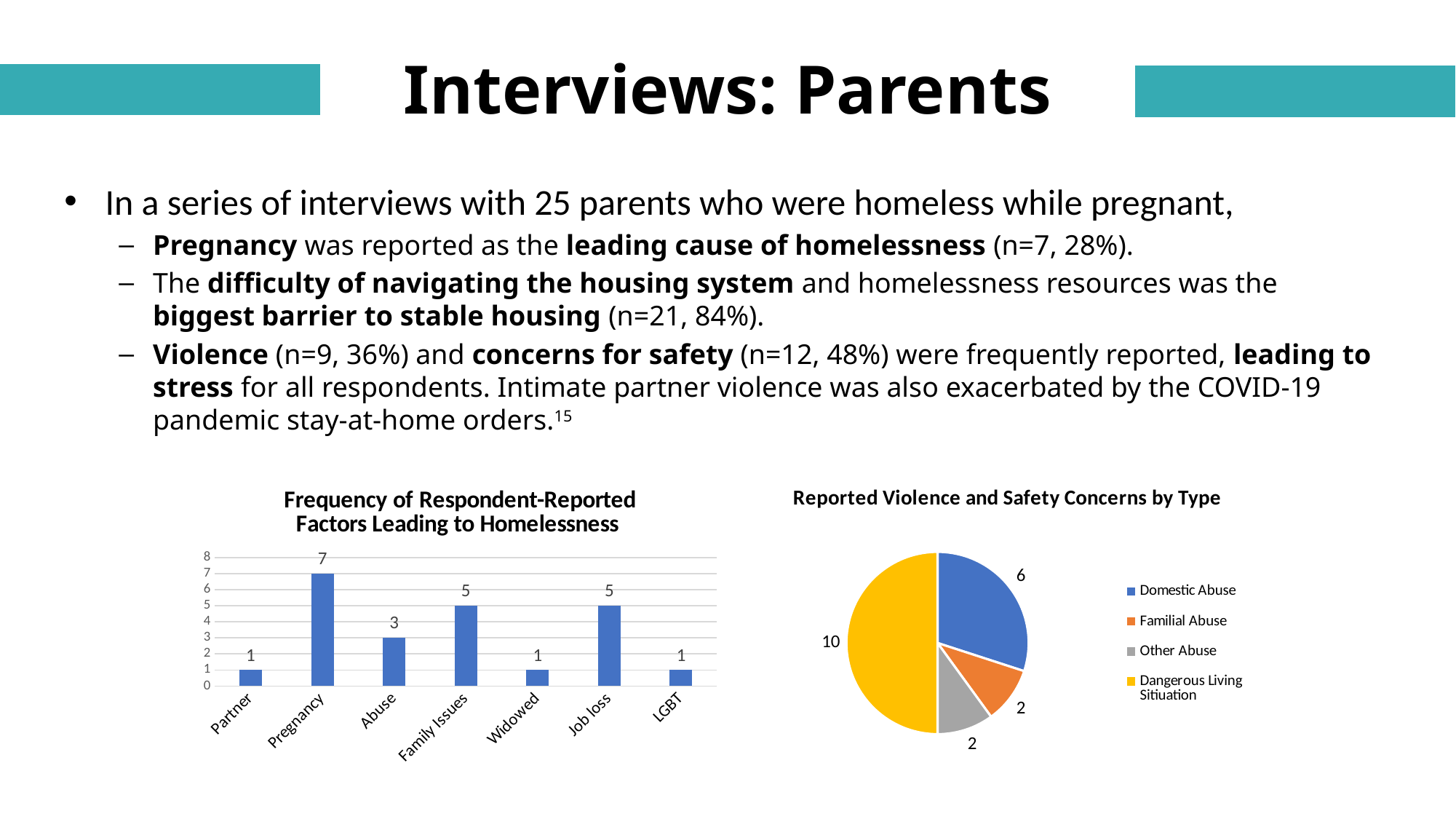
What kind of chart is 'Frequency of Respondent-Reported Factors Leading to Homelessness'? Bar chart In the 'Frequency of Respondent-Reported Factors Leading to Homelessness' chart, what is the value for Abuse? 3 What kind of chart is 'Reported Violence and Safety Concerns by Type'? Pie chart In the 'Frequency of Respondent-Reported Factors Leading to Homelessness' chart, which factor has the highest value? Pregnancy In the 'Frequency of Respondent-Reported Factors Leading to Homelessness' chart, what is the difference between the values for Pregnancy and Family Issues? 2 How many entries does the legend of the 'Reported Violence and Safety Concerns by Type' chart list? 4 In the 'Frequency of Respondent-Reported Factors Leading to Homelessness' chart, which is larger, the value for Abuse or the value for Job loss? Job loss How many categories are shown in the 'Frequency of Respondent-Reported Factors Leading to Homelessness' chart? 7 In the 'Reported Violence and Safety Concerns by Type' chart, what share of the total does Dangerous Living Situation represent? 50% In the 'Frequency of Respondent-Reported Factors Leading to Homelessness' chart, what is the value for Pregnancy? 7 In the 'Reported Violence and Safety Concerns by Type' chart, which type has the largest slice? Dangerous Living Situation In the 'Reported Violence and Safety Concerns by Type' chart, what is the value for Domestic Abuse? 6